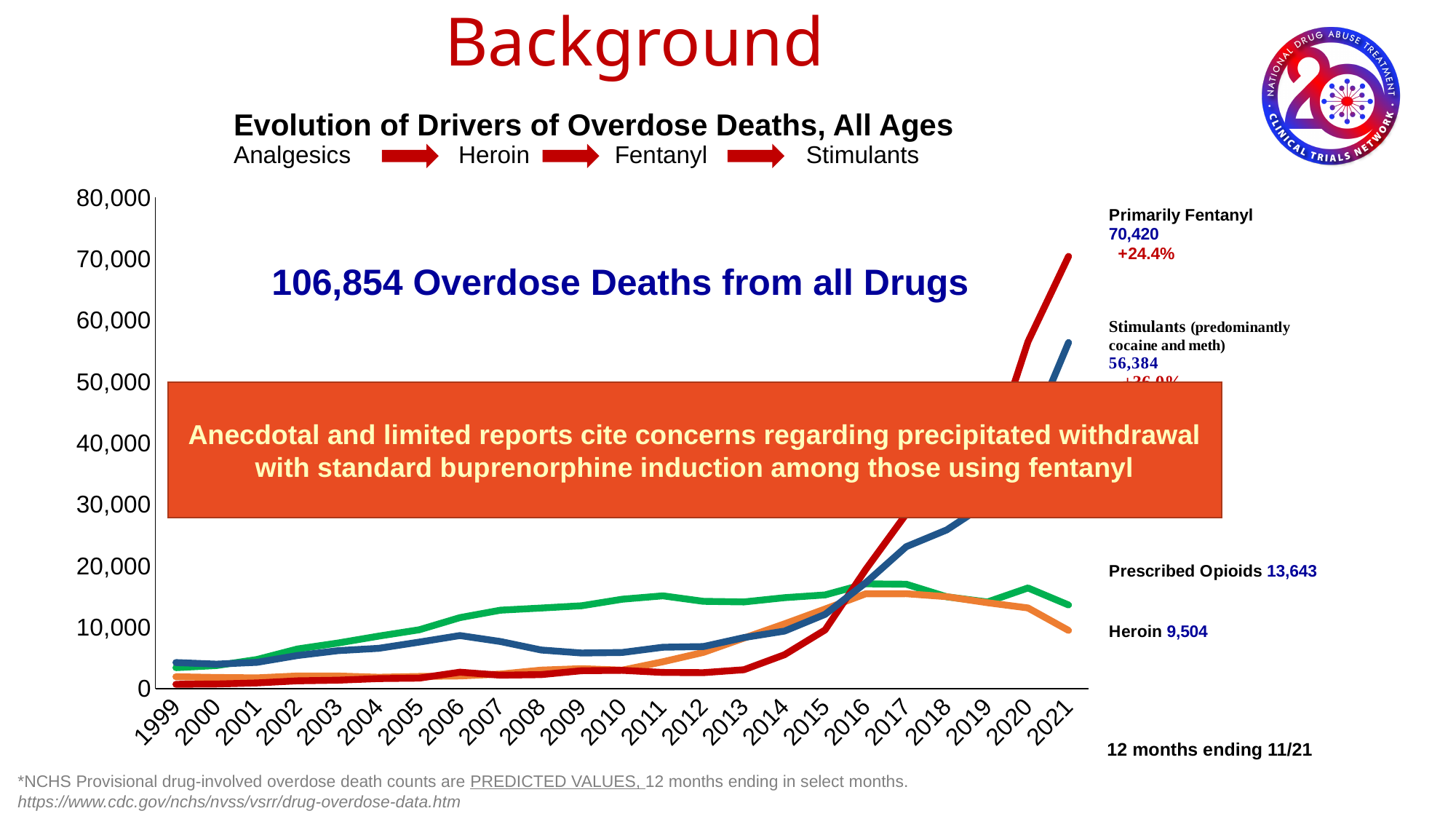
What is the title of the chart? Evolution of Drivers of Overdose Deaths, All Ages What is the value labelled for Heroin at the end of the series? 9,504 What is the value labelled for Primarily Fentanyl at the end of the series (2021)? 70,420 What percentage change is labelled for Primarily Fentanyl? +24.4% How many years are shown on the x axis? 23 What kind of chart is shown on the slide? line chart What is the difference between the 2021 values for Primarily Fentanyl and Stimulants? 14,036 What is the value labelled for Stimulants (predominantly cocaine and meth) at the end of the series? 56,384 Which series has the highest value in 2021? Primarily Fentanyl Is the value for Prescribed Opioids in 2016 greater or less than 20,000? less What is the value labelled for Prescribed Opioids at the end of the series? 13,643 Which series has the lowest value in 2021? Heroin